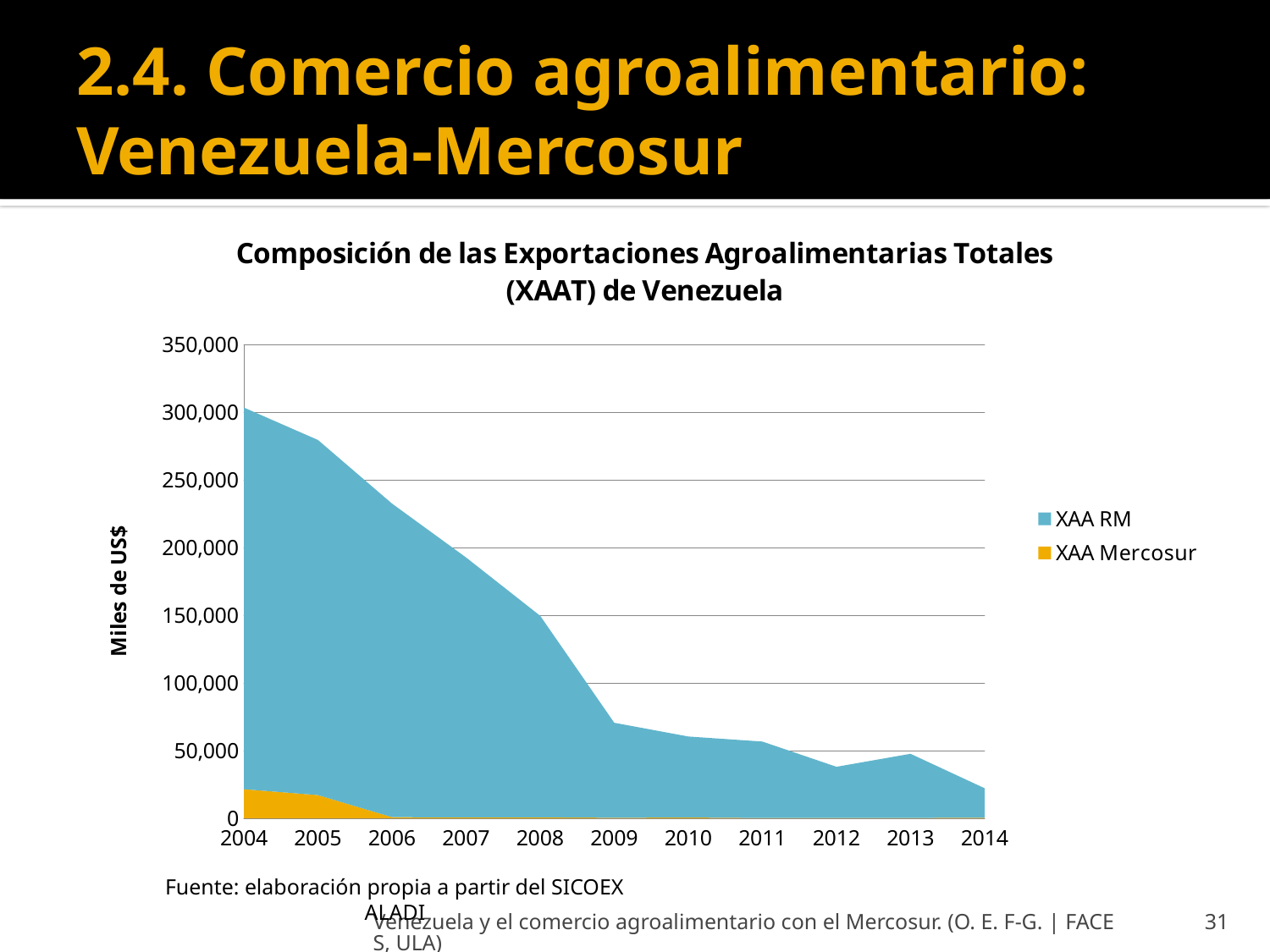
What kind of chart is shown on the slide? Area chart Is the total value for 2014 greater or less than 50,000? less In which year is the total of the stacked areas highest? 2004 How many series does the legend list? 2 Is the total value for 2012 greater or less than 50,000? less Which is larger, the XAA Mercosur value in 2004 or in 2006? 2004 Do the total exports rise or fall from 2004 to 2014? Fall Is the total value for 2004 greater or less than 250,000? greater What is the label of the y axis? Miles de US$ How many years are shown on the x axis? 11 In which year is the total of the stacked areas lowest? 2014